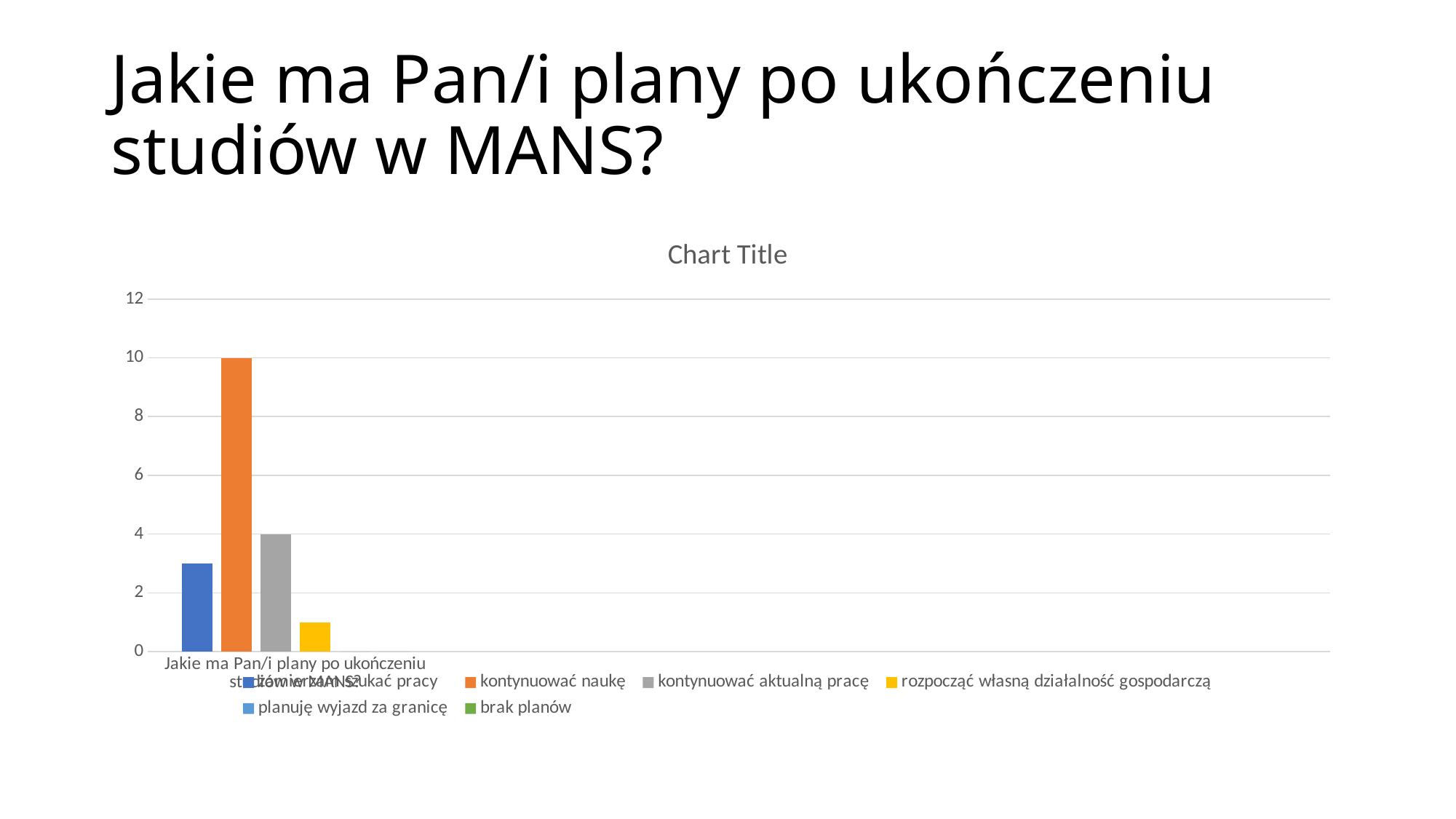
Is the value for "rozpocząć własną działalność gospodarczą" greater or less than 2? less What is the value for "kontynuować aktualną pracę"? 4 What type of chart is shown on the slide? bar chart What colour is the bar for "kontynuować naukę"? orange What is the difference between the values for "kontynuować naukę" and "kontynuować aktualną pracę"? 6 What is the title shown above the chart? Chart Title Which is larger, the value for "kontynuować naukę" or the value for "kontynuować aktualną pracę"? kontynuować naukę Is the value for the blue series (first legend entry) greater or less than 2? greater How many series does the legend list? 6 Which series has the highest value? kontynuować naukę Is the value for "kontynuować naukę" greater or less than 8? greater What is the value for "kontynuować naukę"? 10